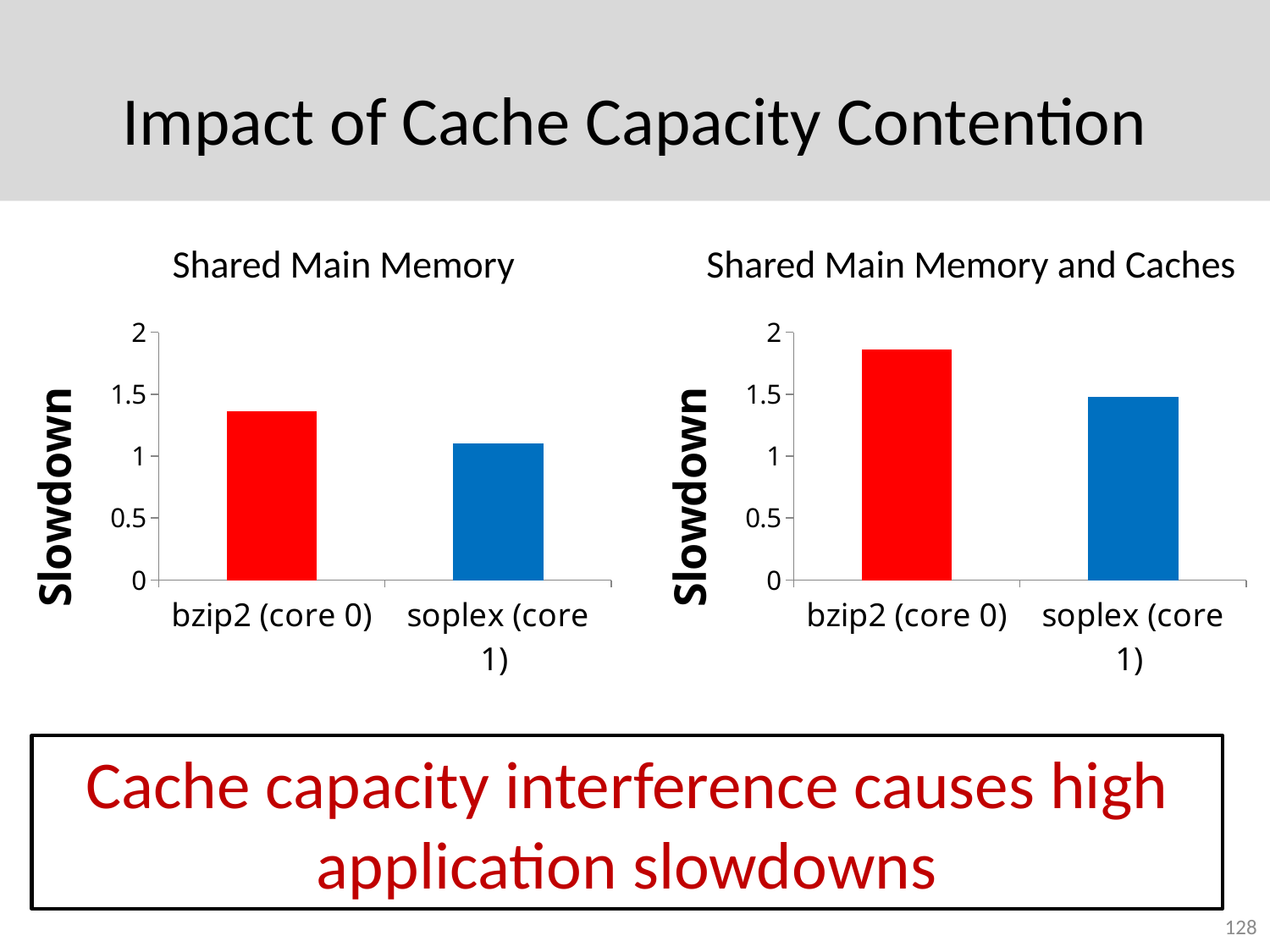
In the Shared Main Memory and Caches chart, is the slowdown for bzip2 (core 0) greater or less than 1.5? greater What is the y-axis label of the Shared Main Memory chart? Slowdown In the Shared Main Memory and Caches chart, which has the larger slowdown, bzip2 (core 0) or soplex (core 1)? bzip2 (core 0) What kind of chart is the Shared Main Memory and Caches chart? bar chart How many categories are shown in the Shared Main Memory chart? 2 In the Shared Main Memory chart, which category has the highest slowdown? bzip2 (core 0) In the Shared Main Memory and Caches chart, is the slowdown for soplex (core 1) greater or less than 1? greater In the Shared Main Memory chart, is the slowdown for soplex (core 1) greater or less than 1? greater Is the slowdown for bzip2 (core 0) larger in the Shared Main Memory chart or in the Shared Main Memory and Caches chart? Shared Main Memory and Caches In the Shared Main Memory and Caches chart, which category has the highest slowdown? bzip2 (core 0) In the Shared Main Memory chart, which category has the lowest slowdown? soplex (core 1)